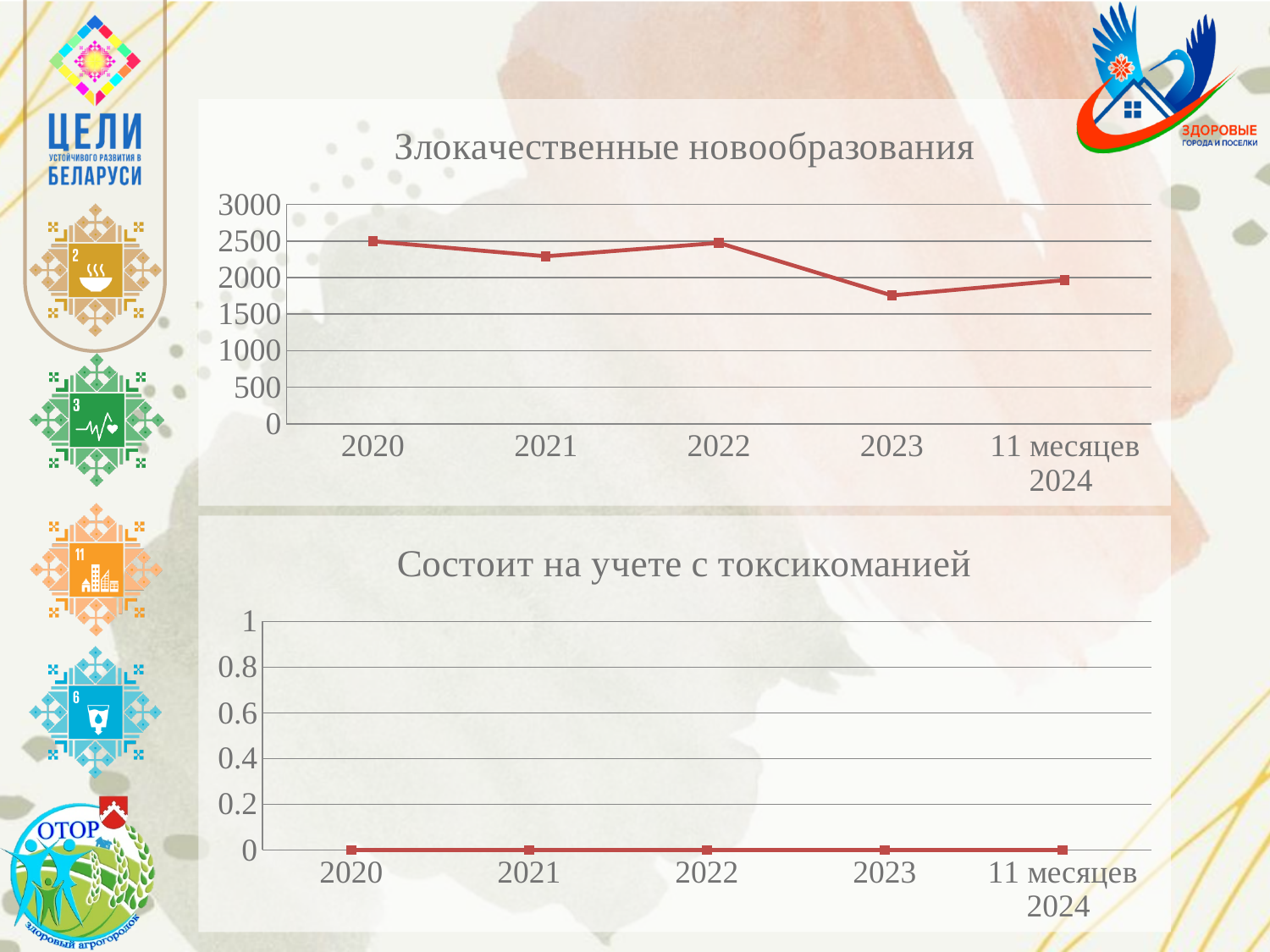
What is the title of the top chart on the slide? Злокачественные новообразования In the top chart "Злокачественные новообразования", is the value for 2020 greater or less than 2000? greater In the top chart "Злокачественные новообразования", which is larger, the value for 2022 or the value for 2023? 2022 What kind of chart is the bottom chart titled "Состоит на учете с токсикоманией"? line chart In the bottom chart "Состоит на учете с токсикоманией", do the values rise, fall, or stay flat across the years? stay flat In the bottom chart "Состоит на учете с токсикоманией", what is the value for 2022? 0 In the top chart "Злокачественные новообразования", is the value for 2021 greater or less than 2500? less In the top chart "Злокачественные новообразования", how many data points are plotted? 5 In the top chart "Злокачественные новообразования", which year has the lowest value? 2023 In the top chart "Злокачественные новообразования", is the value for 2023 greater or less than 2000? less What kind of chart is the top chart titled "Злокачественные новообразования"? line chart In the bottom chart "Состоит на учете с токсикоманией", how many categories are shown on the x axis? 5